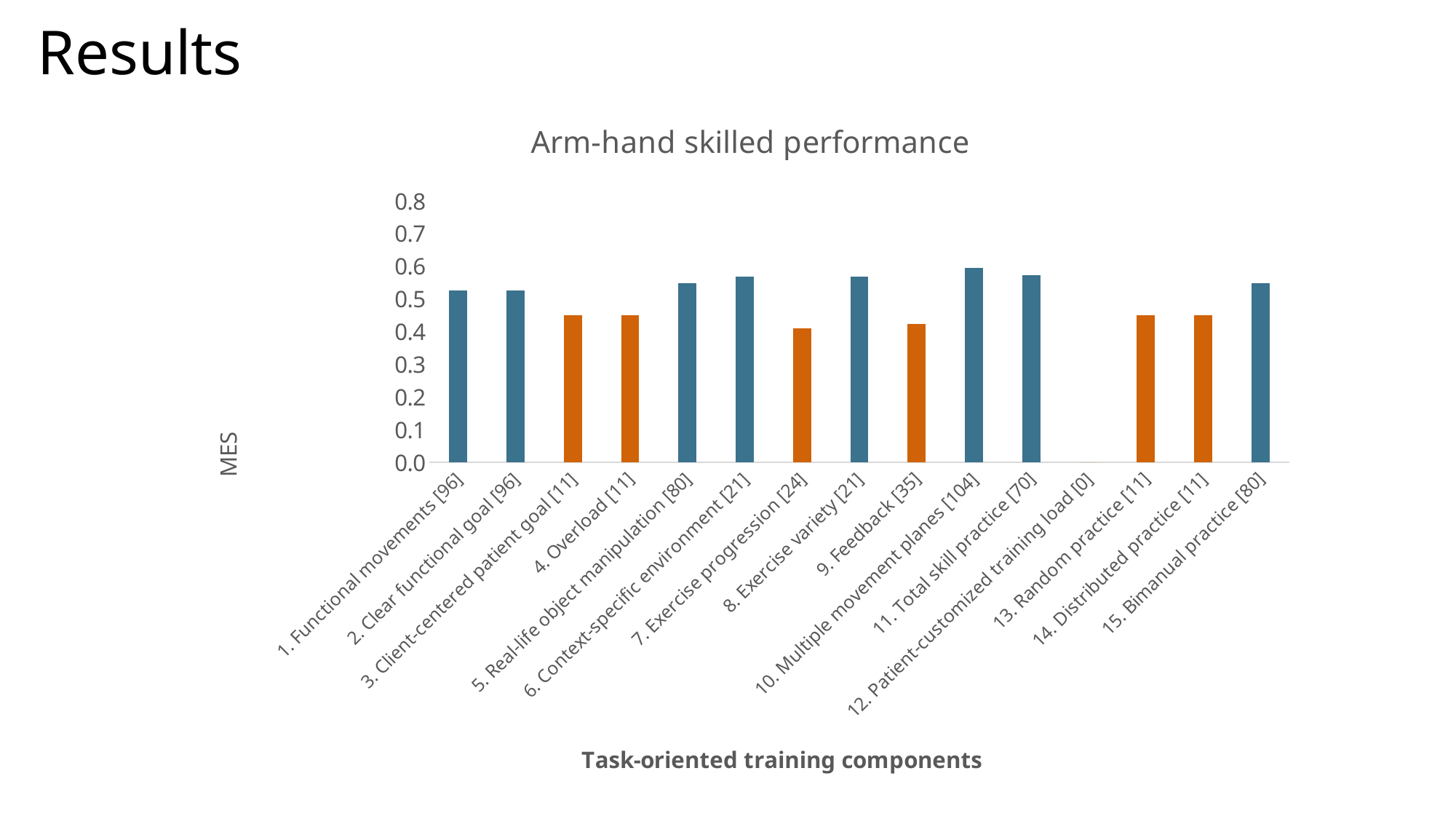
Is the MES value for 6. Context-specific environment [21] greater or less than 0.5? greater Which training component has the lowest MES value? 12. Patient-customized training load [0] Which training component has the highest MES value? 10. Multiple movement planes [104] What kind of chart is shown on the slide? Bar chart Is the MES value for 9. Feedback [35] greater or less than 0.5? less What is the label on the x axis of the chart? Task-oriented training components What is the title of the chart? Arm-hand skilled performance Is the MES value for 1. Functional movements [96] greater or less than 0.5? greater Which has a larger MES value: 10. Multiple movement planes [104] or 9. Feedback [35]? 10. Multiple movement planes [104] Which has a larger MES value: 6. Context-specific environment [21] or 7. Exercise progression [24]? 6. Context-specific environment [21] How many training components are listed along the x axis? 15